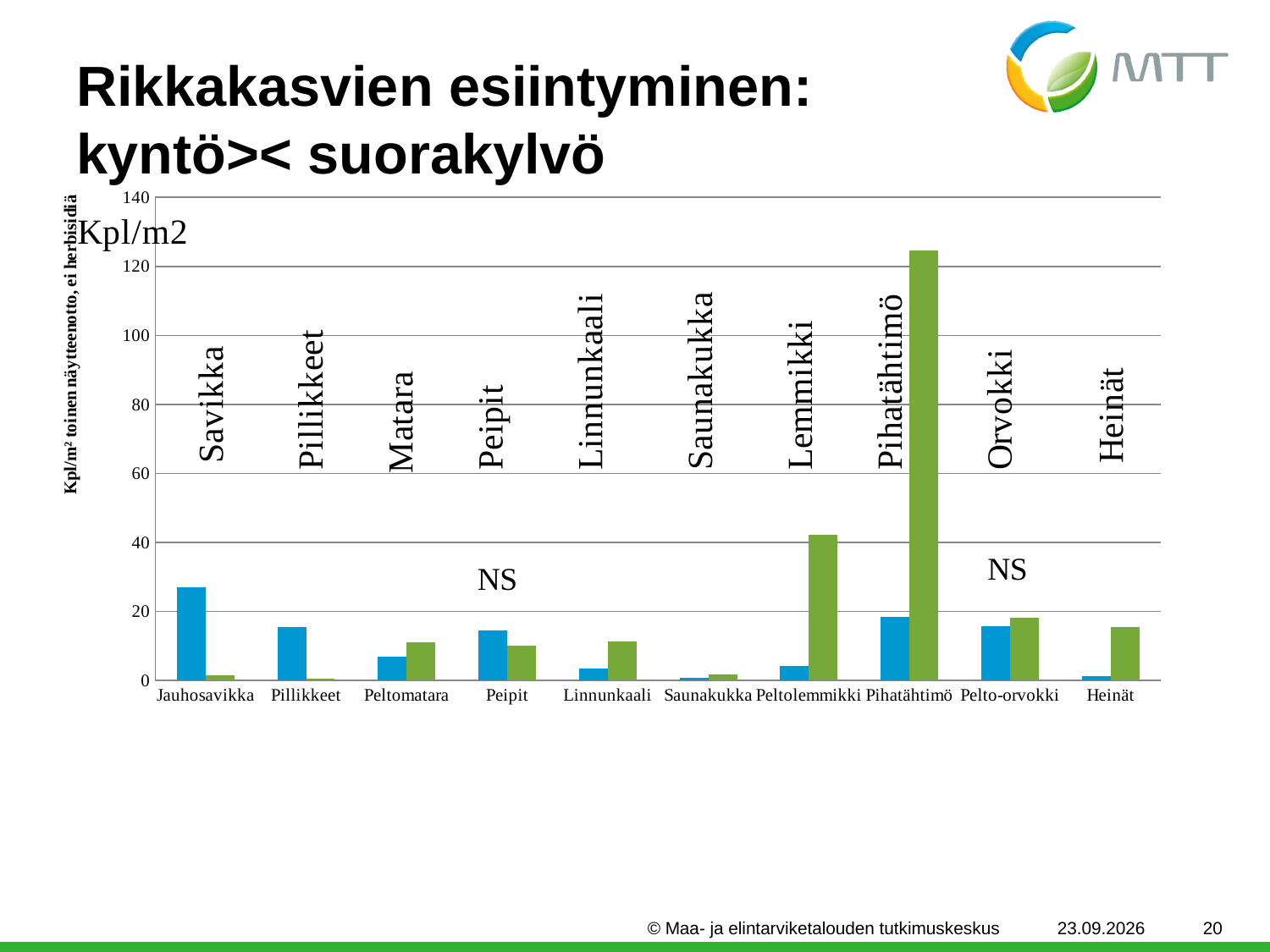
Is the blue bar for Pihatähtimö greater or less than 20? less Is the green bar for Peltolemmikki greater or less than 40? greater What kind of chart is shown on the slide? bar chart Which category has the lowest green bar? Pillikkeet Which category has the tallest blue bar? Jauhosavikka How many categories are shown along the x axis of the chart? 10 For Jauhosavikka, which bar is taller, the blue one or the green one? blue For Peltolemmikki, which bar is taller, the blue one or the green one? green Is the blue bar for Jauhosavikka greater or less than 20? greater Which category has the tallest green bar? Pihatähtimö What unit label is printed at the top left of the plot area? Kpl/m2